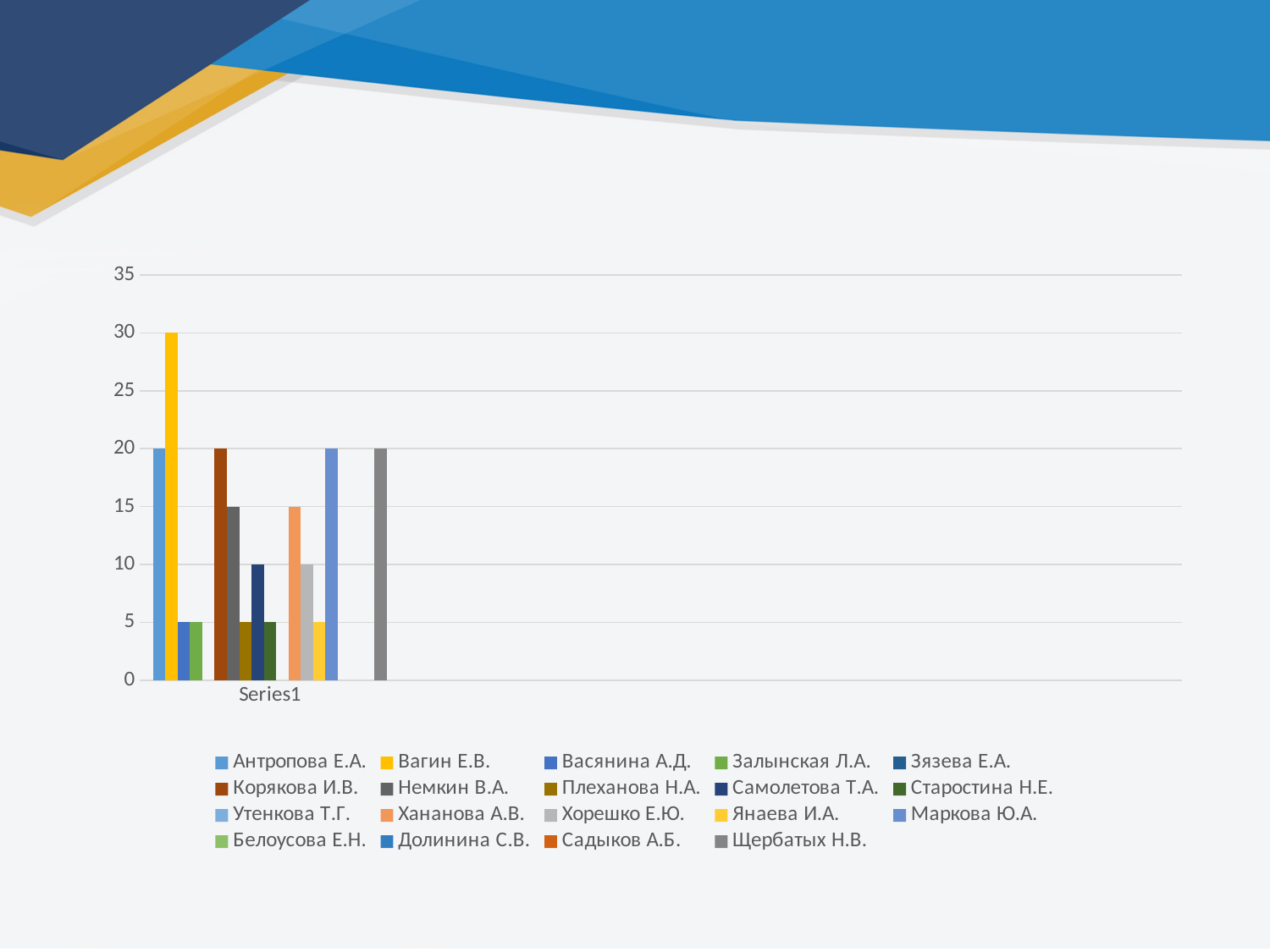
What is the difference between the values for Вагин Е.В. and Антропова Е.А.? 10 How many series does the legend list? 19 What is the value for Немкин В.А.? 15 What is the value for Антропова Е.А.? 20 Is the value for Вагин Е.В. greater or less than 25? greater What is the value for Самолетова Т.А.? 10 What is the value for Вагин Е.В.? 30 Which is larger, the value for Корякова И.В. or the value for Немкин В.А.? Корякова И.В. What is the label of the single category on the x axis? Series1 How many categories are shown on the x axis? 1 What kind of chart is shown on the slide? bar chart Which series has the highest value? Вагин Е.В.